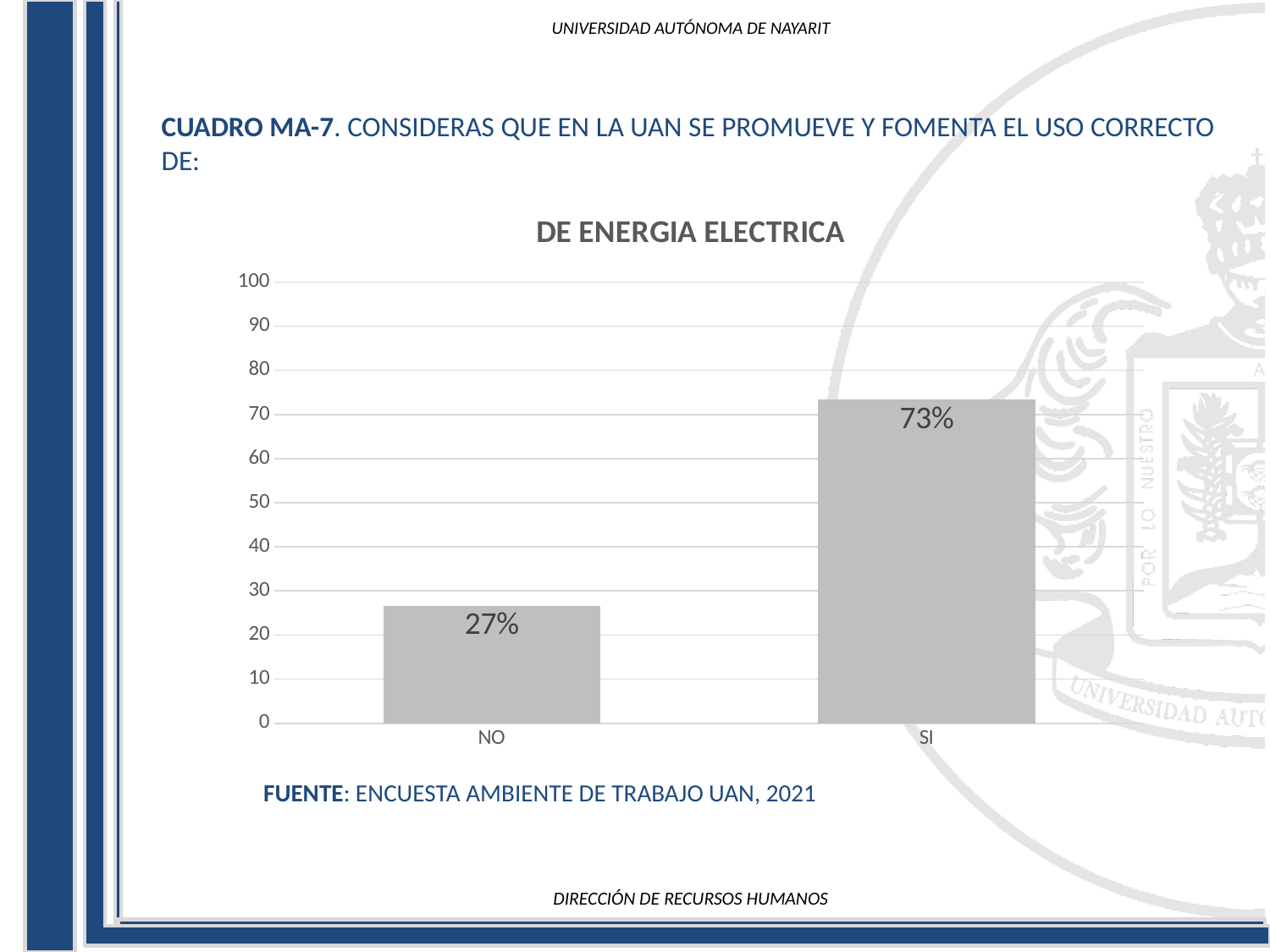
What is the highest value shown on the y axis? 100 Which is larger, the value for NO or the value for SI? SI Is the value for NO greater or less than 40? less Is the value for SI greater or less than 60? greater What is the difference between the values for SI and NO? 46% What is the title of the chart? DE ENERGIA ELECTRICA What kind of chart is shown? bar chart What is the value for NO? 27% Which category has the lowest value? NO How many categories are shown on the x axis? 2 Which category has the highest value? SI What is the value for SI? 73%